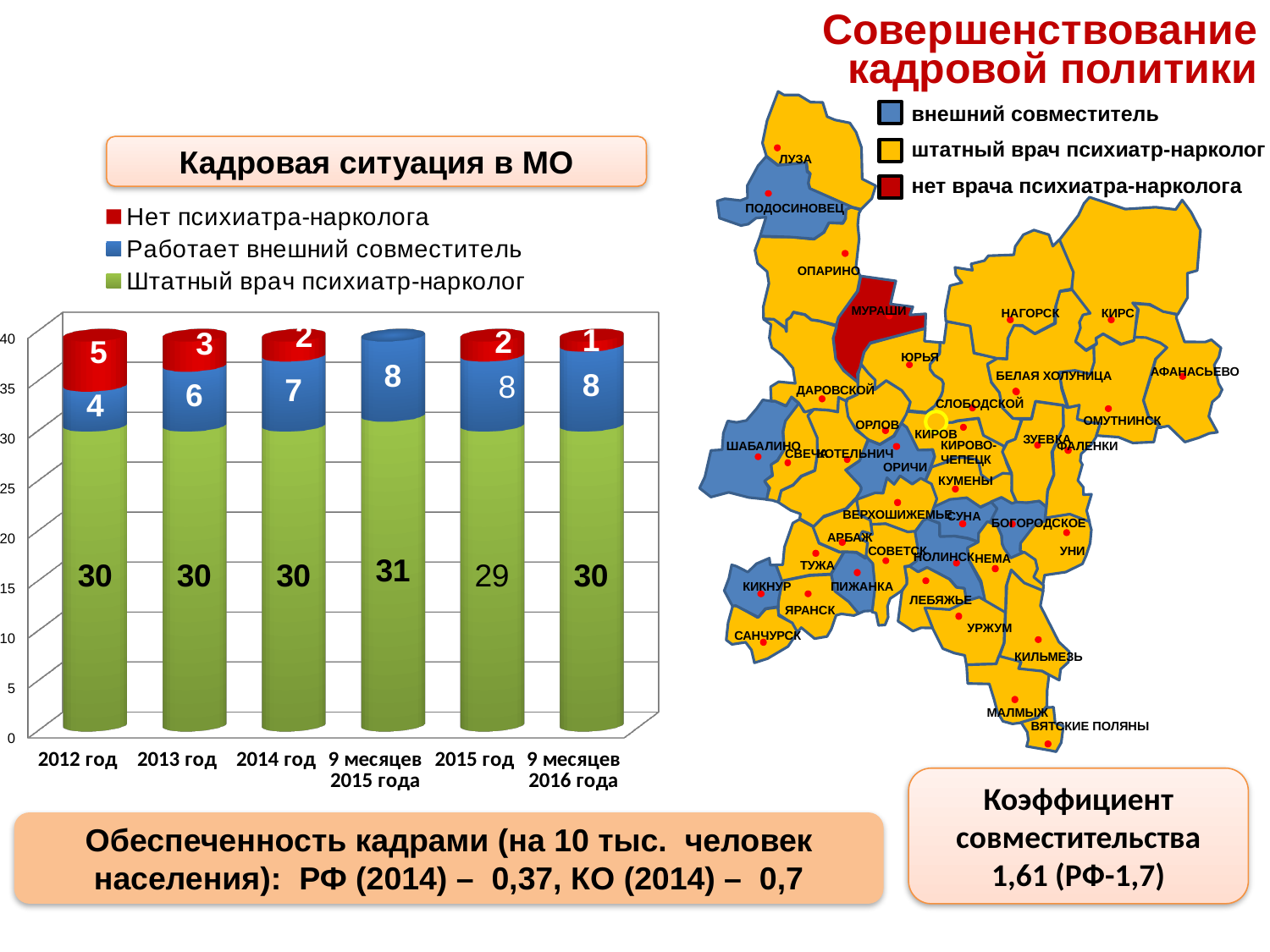
In the "Кадровая ситуация в МО" chart, what is the value of "Штатный врач психиатр-нарколог" for 2015 год? 29 In the "Кадровая ситуация в МО" chart, what is the total of the stacked bar for 2012 год? 39 In the "Кадровая ситуация в МО" chart, what is the difference between the "Работает внешний совместитель" values for 2013 год and 2012 год? 2 How many series does the legend of the "Кадровая ситуация в МО" chart list? 3 In the "Кадровая ситуация в МО" chart, which is larger: "Нет психиатра-нарколога" for 2013 год or for 9 месяцев 2016 года? 2013 год In the "Кадровая ситуация в МО" chart, what is the value of "Нет психиатра-нарколога" for 2012 год? 5 In the "Кадровая ситуация в МО" chart, which colour represents "Штатный врач психиатр-нарколог"? Green What kind of chart is shown under the title "Кадровая ситуация в МО"? Stacked bar chart In the "Кадровая ситуация в МО" chart, what is the value of "Работает внешний совместитель" for 2014 год? 7 How many categories are shown on the x axis of the "Кадровая ситуация в МО" chart? 6 In the "Кадровая ситуация в МО" chart, which category has the lowest value for "Работает внешний совместитель"? 2012 год In the "Кадровая ситуация в МО" chart, which category has the highest value for "Нет психиатра-нарколога"? 2012 год